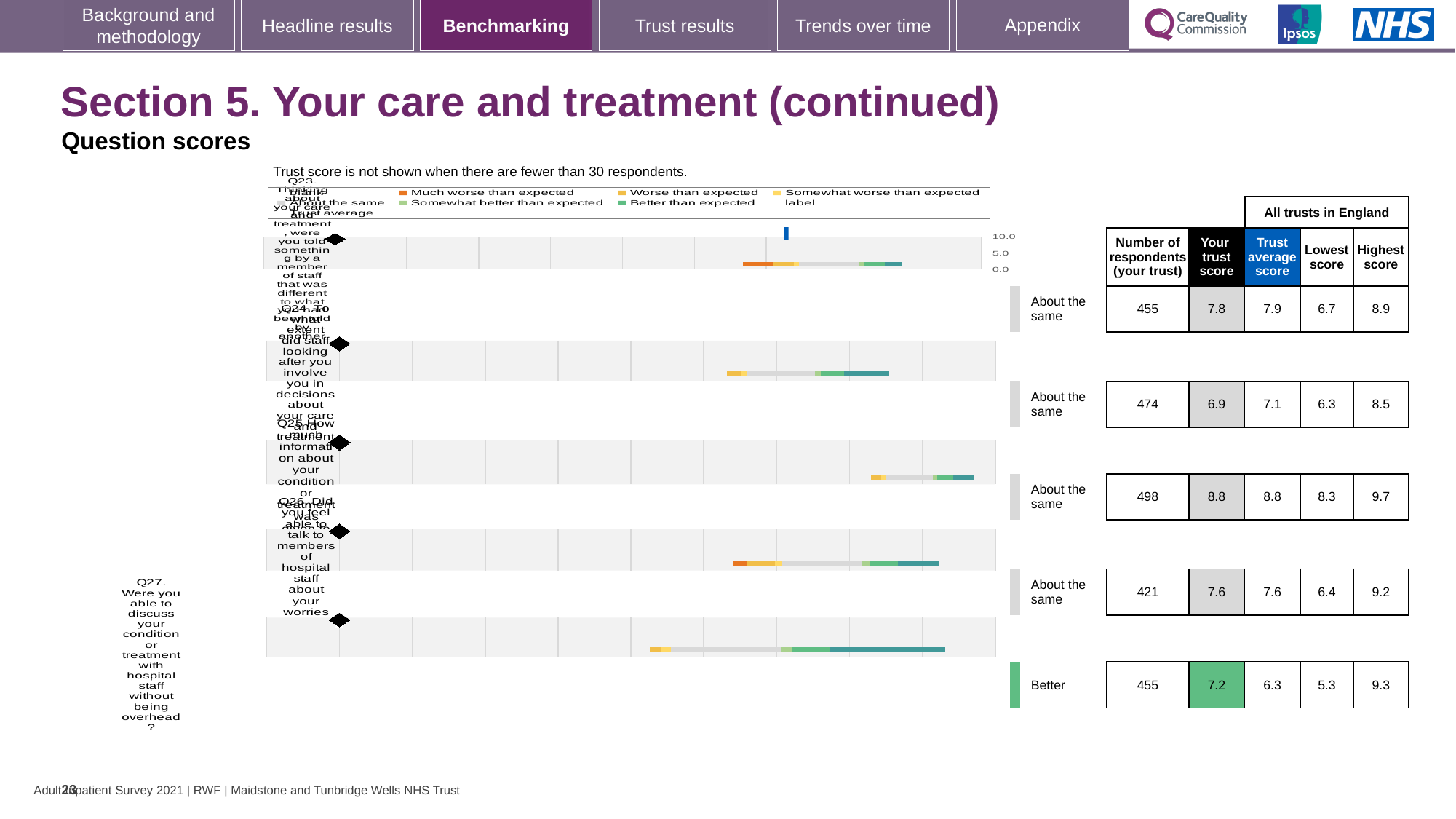
Which question is rated 'Better' rather than 'About the same'? Q27 How many questions (Q23 to Q27) are plotted in the chart? 5 What is the difference between the trust score and the trust average score for Q27? 0.9 According to the note above the chart, when is a trust score not shown? When there are fewer than 30 respondents Which has the larger trust score, Q23 or Q24? Q23 What is the lowest score among all trusts in England for Q27? 5.3 What kind of chart is used to show the question scores on this slide? Bar chart What is the highest score among all trusts in England for Q25? 9.7 Which question has the highest 'Your trust score'? Q25 What is the trust score for Q25 (how much information about your condition or treatment was given)? 8.8 How many respondents answered Q24 for this trust? 474 Which question has the lowest 'Your trust score'? Q24